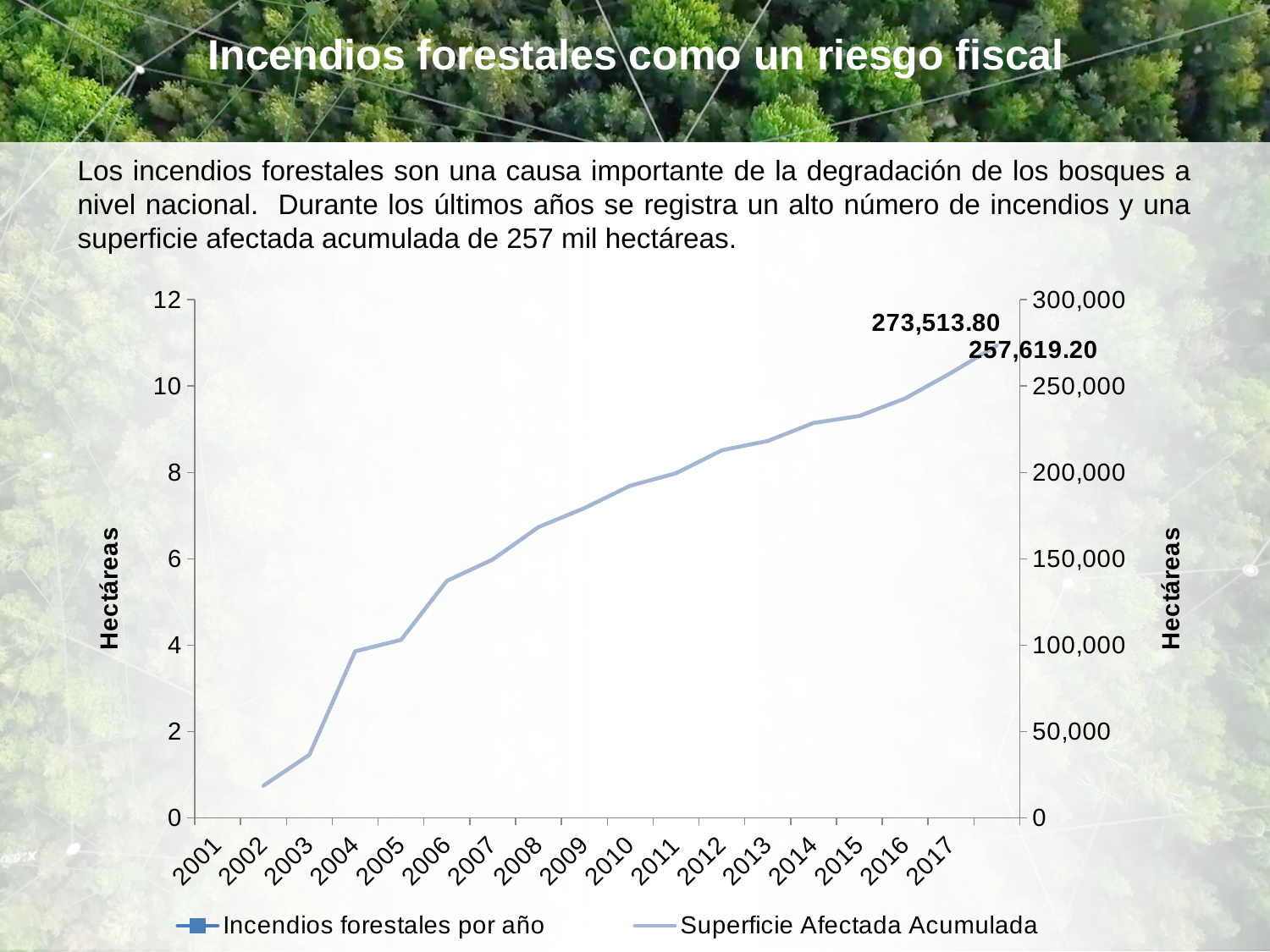
Is the Superficie Afectada Acumulada value for 2002 greater or less than 50,000? less Does the Superficie Afectada Acumulada line rise or fall from 2002 to 2017? rise Is the Superficie Afectada Acumulada value for 2012 greater or less than 200,000? greater Which is larger, the Superficie Afectada Acumulada value for 2006 or for 2010? 2010 How many series does the legend list? 2 What is the title of the right-hand vertical axis? Hectáreas In which year is the Superficie Afectada Acumulada line at its lowest plotted point? 2002 Is the Superficie Afectada Acumulada value for 2017 greater or less than 250,000? greater In which year is the Superficie Afectada Acumulada line at its highest? 2017 How many years are labelled on the x axis? 17 What kind of chart is shown on the slide? line chart